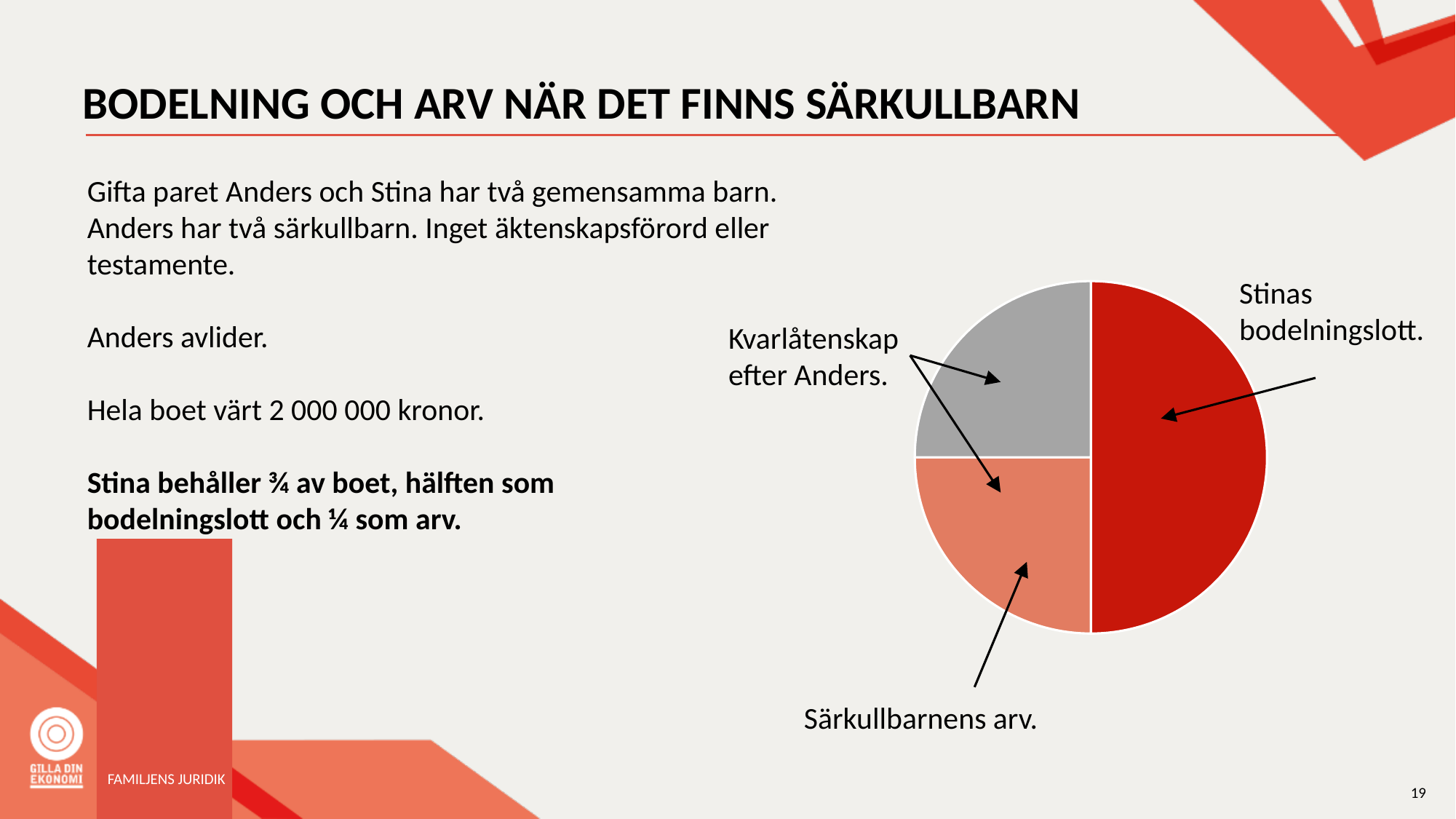
Does the slice for Stinas bodelningslott take up more or less than a quarter of the pie? more Which is larger in the pie chart: Stinas bodelningslott or Särkullbarnens arv? Stinas bodelningslott What colour is the slice labelled Stinas bodelningslott? red How many slices does the pie chart have? 3 Which slice of the pie chart is the largest? Stinas bodelningslott Does the slice for Särkullbarnens arv take up more or less than half of the pie? less What kind of chart is shown on the slide? pie chart What colour is the slice labelled Särkullbarnens arv? salmon/light red